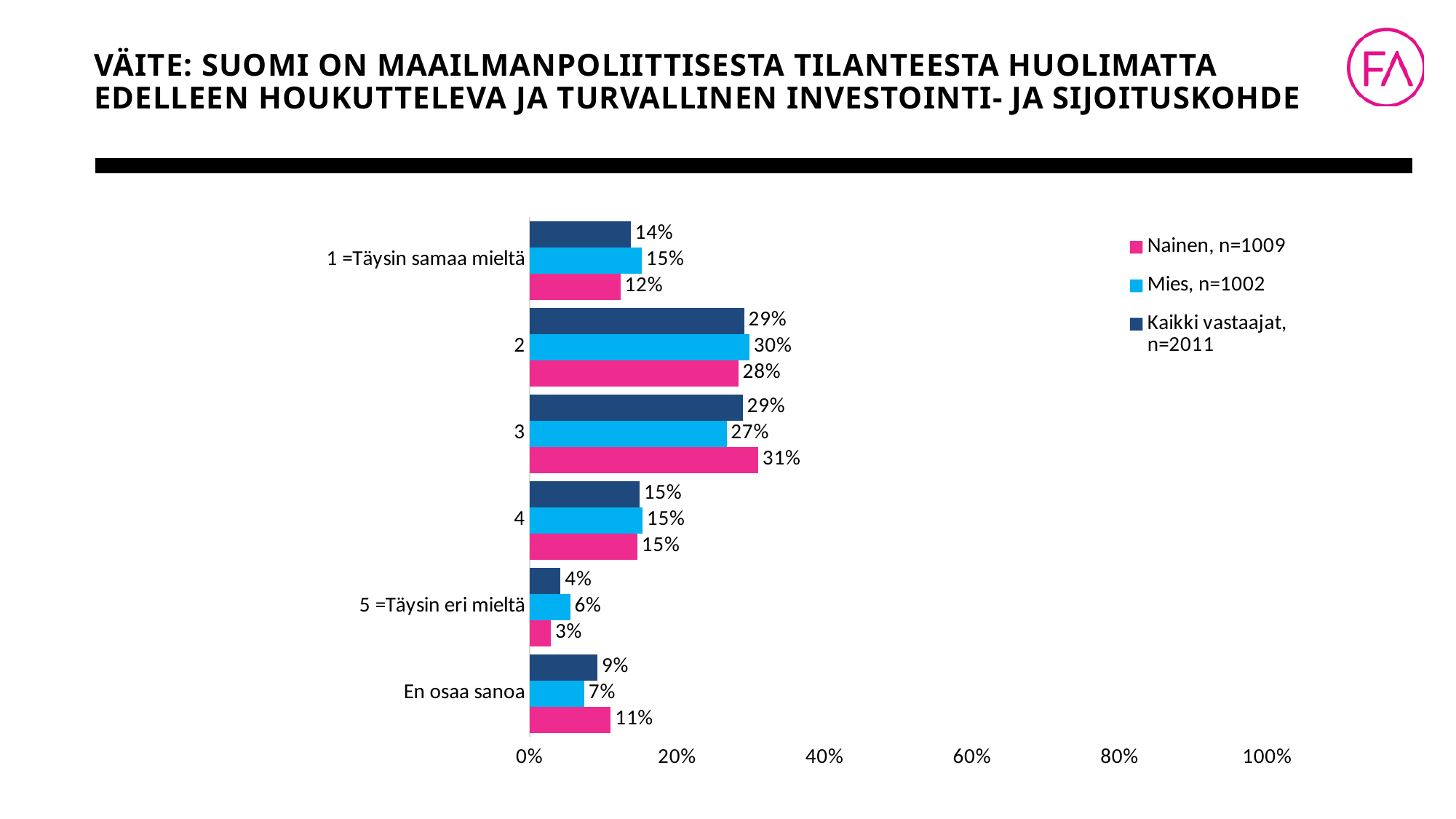
What percentage of 'Mies, n=1002' respondents chose '5 =Täysin eri mieltä'? 6% What is the difference between the 'Nainen, n=1009' and 'Mies, n=1002' values in the category 'En osaa sanoa'? 4% How many categories are shown on the chart? 6 How many series does the legend list? 3 Which colour represents the 'Mies, n=1002' series? Light blue In the category '3', which is larger: the value for 'Nainen, n=1009' or for 'Mies, n=1002'? Nainen, n=1009 Which category has the lowest value for the 'Nainen, n=1009' series? 5 =Täysin eri mieltä What percentage of 'Nainen, n=1009' respondents chose '3'? 31% What is the value for 'Kaikki vastaajat, n=2011' in the category 'En osaa sanoa'? 9% Is the value for 'Kaikki vastaajat, n=2011' in category '2' greater or less than 20%? greater Which category has the highest value for the 'Mies, n=1002' series? 2 What kind of chart is shown on the slide? Bar chart